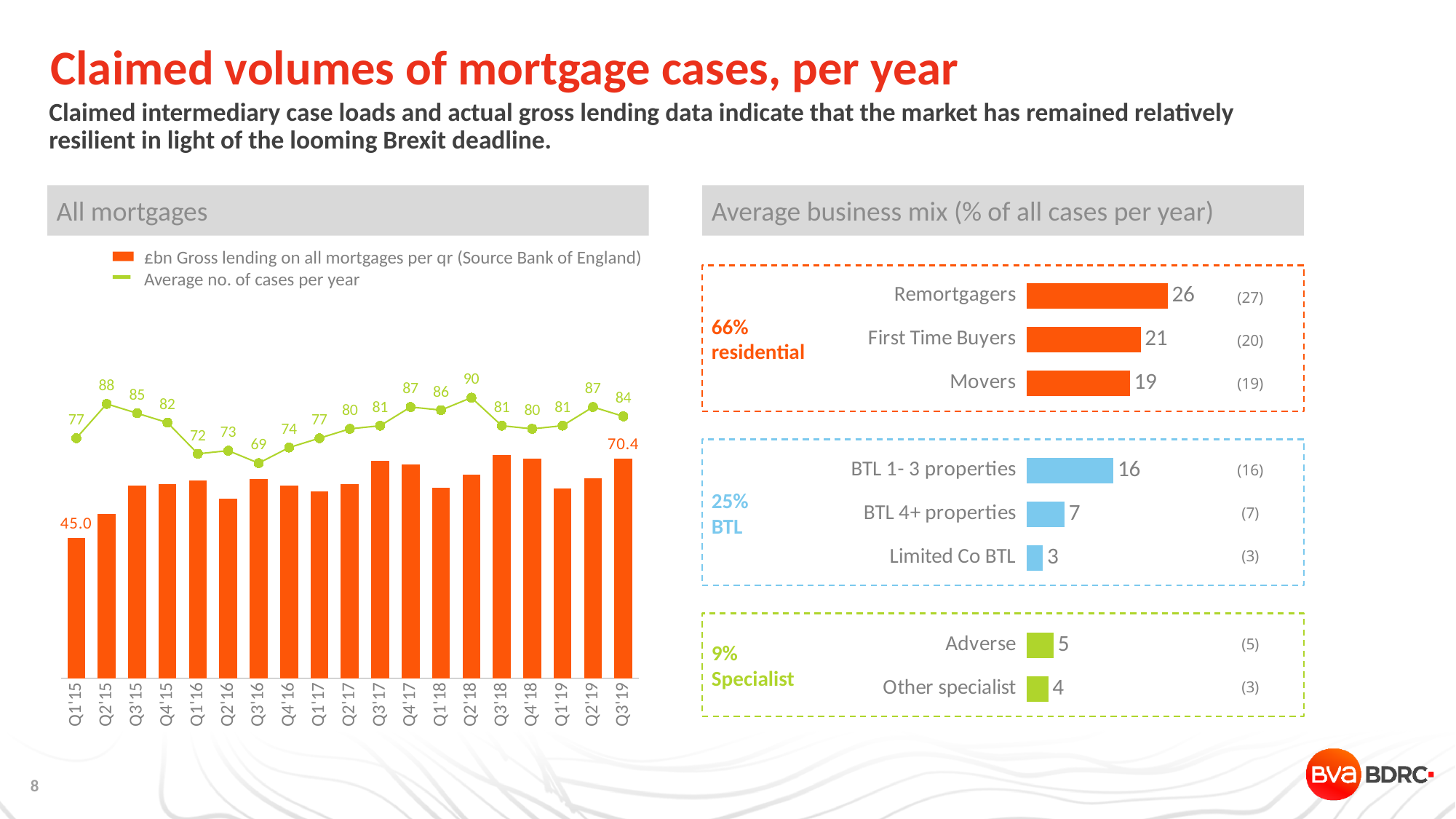
In the 'All mortgages' chart, what is the £bn gross lending value labelled for Q3'19? 70.4 In the 'Average business mix' chart, what percentage of all cases are Remortgagers? 26 In the 'Average business mix' chart, how many categories are shown? 8 What type of chart is the 'Average business mix' chart? Bar chart In the 'Average business mix' chart, which category has the highest share of cases? Remortgagers In the 'All mortgages' chart, what is the average number of cases per year for Q2'18? 90 In the 'All mortgages' chart, how many series does the legend list? 2 In the 'All mortgages' chart, is the average number of cases per year higher in Q4'17 or Q1'18? Q4'17 In the 'All mortgages' chart, which quarter has the lowest average number of cases per year? Q3'16 In the 'All mortgages' chart, how many quarters are shown on the x axis? 19 In the 'All mortgages' chart, what is the difference between the average number of cases per year in Q2'15 and Q1'15? 11 In the 'Average business mix' chart, what is the difference between First Time Buyers and Movers? 2